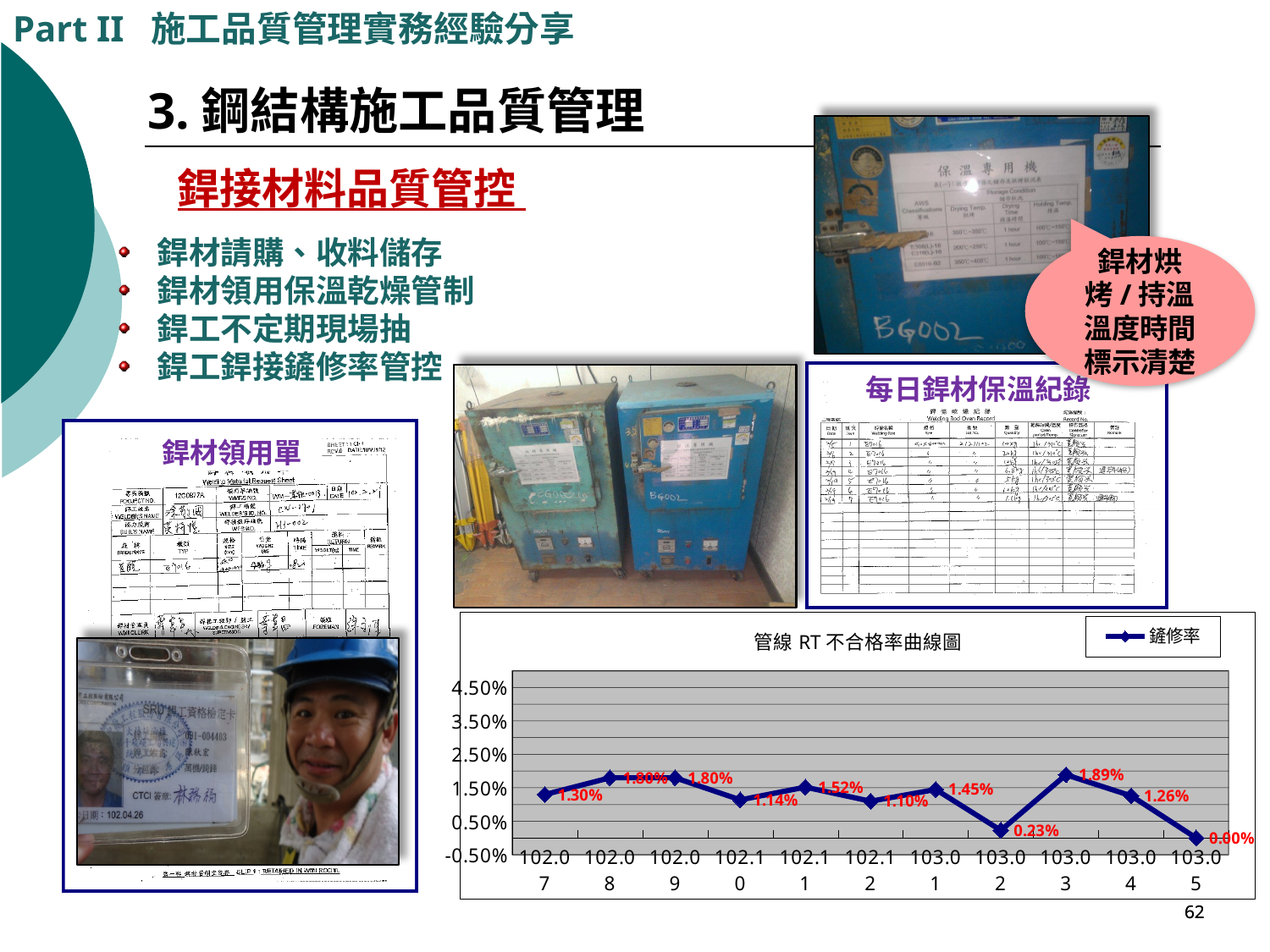
In the 管線 RT 不合格率曲線圖, which is larger, the value for 102.10 or the value for 103.01? 103.01 How many series does the legend of the 管線 RT 不合格率曲線圖 list? 1 In the 管線 RT 不合格率曲線圖, which period has the highest value? 103.03 What is the legend entry of the 管線 RT 不合格率曲線圖? 鏟修率 In the 管線 RT 不合格率曲線圖, what is the value for 103.02? 0.23% How many data points are plotted in the 管線 RT 不合格率曲線圖? 11 In the 管線 RT 不合格率曲線圖, what is the value for 102.07? 1.30% In the 管線 RT 不合格率曲線圖, which period has the lowest value? 103.05 What type of chart is the 管線 RT 不合格率曲線圖? line chart In the 管線 RT 不合格率曲線圖, what is the value for 103.04? 1.26% In the 管線 RT 不合格率曲線圖, what is the difference between the values for 103.03 and 103.02? 1.66% In the 管線 RT 不合格率曲線圖, what is the value for 102.11? 1.52%